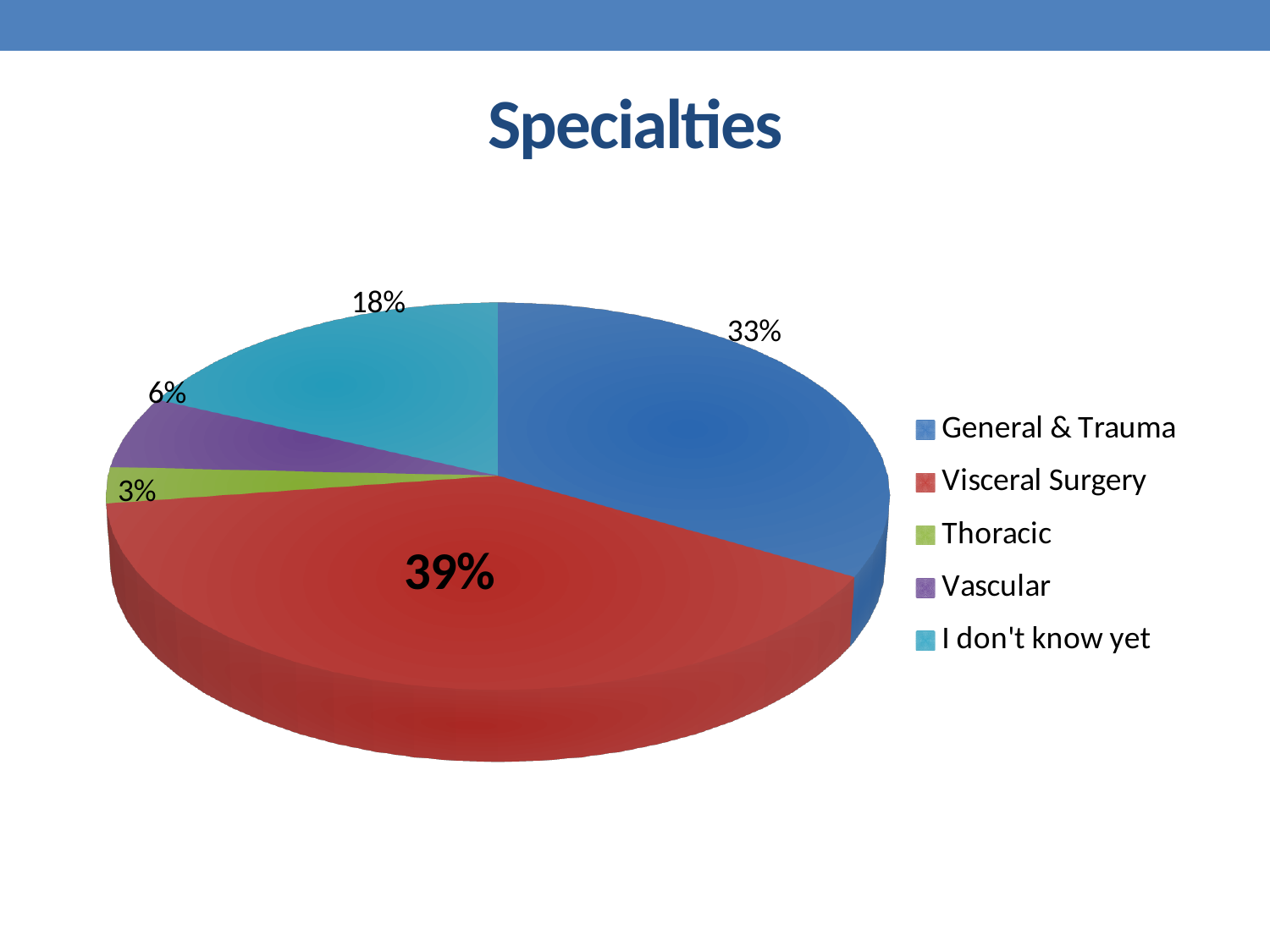
What share of the pie does Vascular have? 6% What share of the pie does Thoracic have? 3% How many categories does the pie chart show? 5 What share of the pie does Visceral Surgery have? 39% What is the title of the chart? Specialties What is the difference in percentage points between Visceral Surgery and General & Trauma? 6 Which is larger, the share for Vascular or the share for 'I don't know yet'? I don't know yet What kind of chart is shown on the slide? pie chart Which specialty has the largest share of the pie? Visceral Surgery Which specialty has the smallest share of the pie? Thoracic